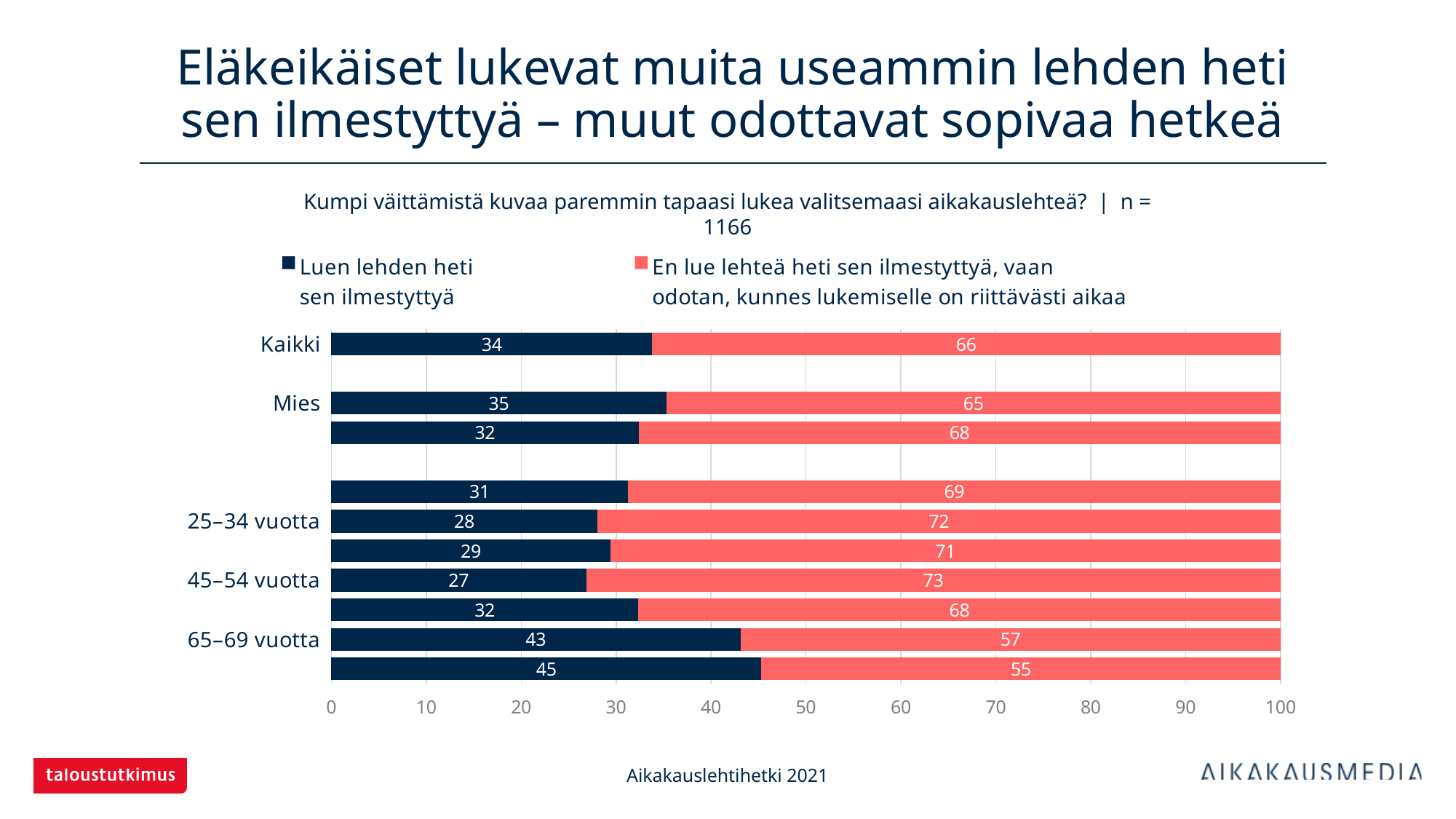
Which has a larger "Luen lehden heti sen ilmestyttyä" value, Mies or 25–34 vuotta? Mies How many series does the legend list? 2 Among Kaikki, Mies, 25–34 vuotta, 45–54 vuotta and 65–69 vuotta, which has the lowest "Luen lehden heti sen ilmestyttyä" value? 45–54 vuotta What kind of chart is shown on the slide? bar chart What is the value of "Luen lehden heti sen ilmestyttyä" for 65–69 vuotta? 43 What is the value of "En lue lehteä heti sen ilmestyttyä, vaan odotan, kunnes lukemiselle on riittävästi aikaa" for 45–54 vuotta? 73 How many stacked bars are plotted in the chart? 10 What is the value of "Luen lehden heti sen ilmestyttyä" for Kaikki? 34 What is the value of "En lue lehteä heti sen ilmestyttyä, vaan odotan, kunnes lukemiselle on riittävästi aikaa" for Mies? 65 What is the difference between the "Luen lehden heti sen ilmestyttyä" values for 65–69 vuotta and 45–54 vuotta? 16 What is the total of the stacked bar for Kaikki? 100 What is the value of "Luen lehden heti sen ilmestyttyä" for 25–34 vuotta? 28